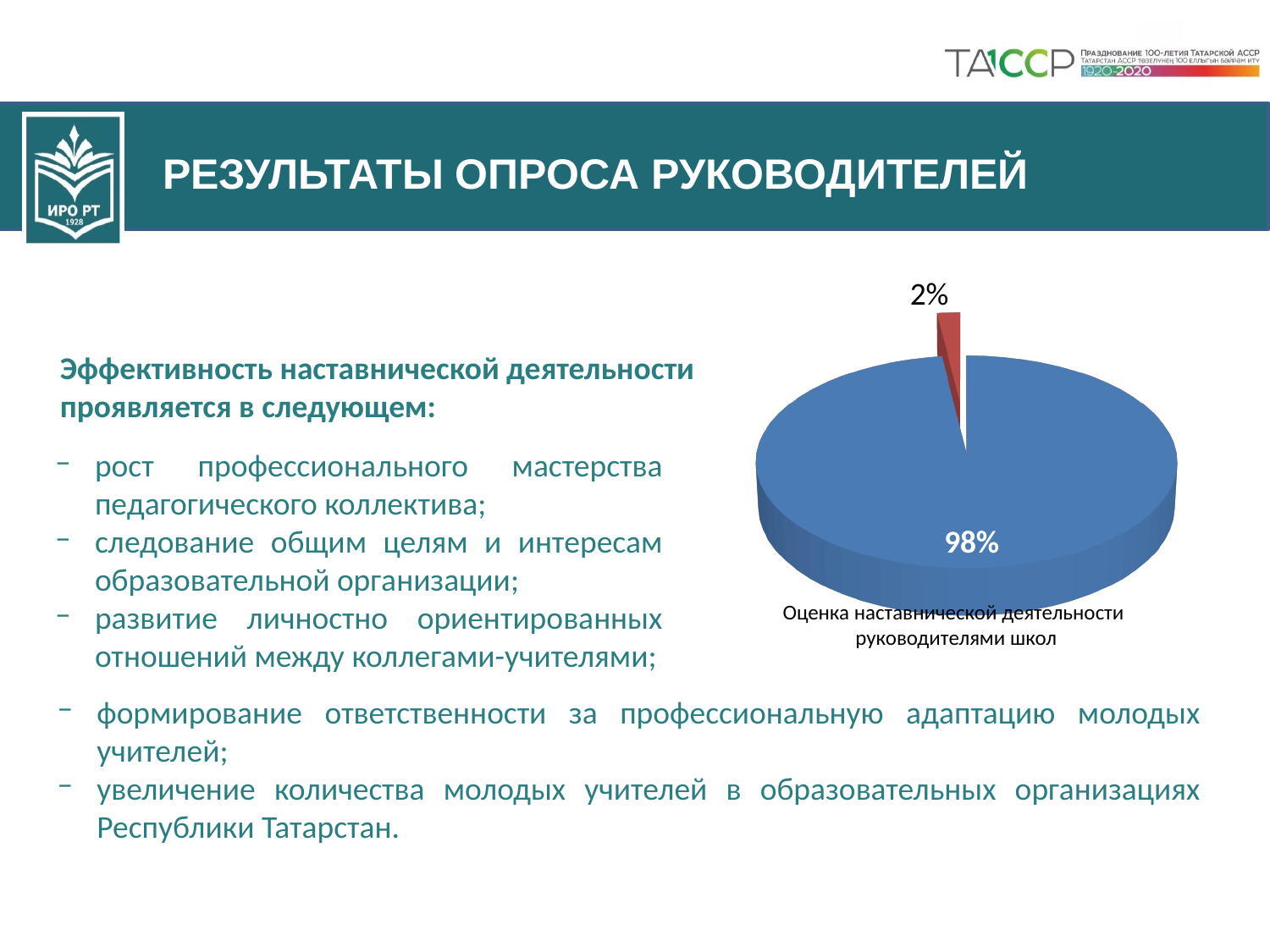
What do the two slices of the pie chart add up to? 100% Which slice is larger, the blue one or the red one? the blue one What is the value of the largest slice of the pie chart? 98% What colour is the slice labelled 2%? red What is the value of the smallest slice of the pie chart? 2% What is the caption written under the pie chart? Оценка наставнической деятельности руководителями школ What value is shown on the red slice of the pie chart? 2% What is the difference between the two slices of the pie chart? 96% Is the value of the largest slice greater or less than 50%? greater How many slices does the pie chart have? 2 What kind of chart is shown on the slide? pie chart What value is shown on the blue slice of the pie chart? 98%